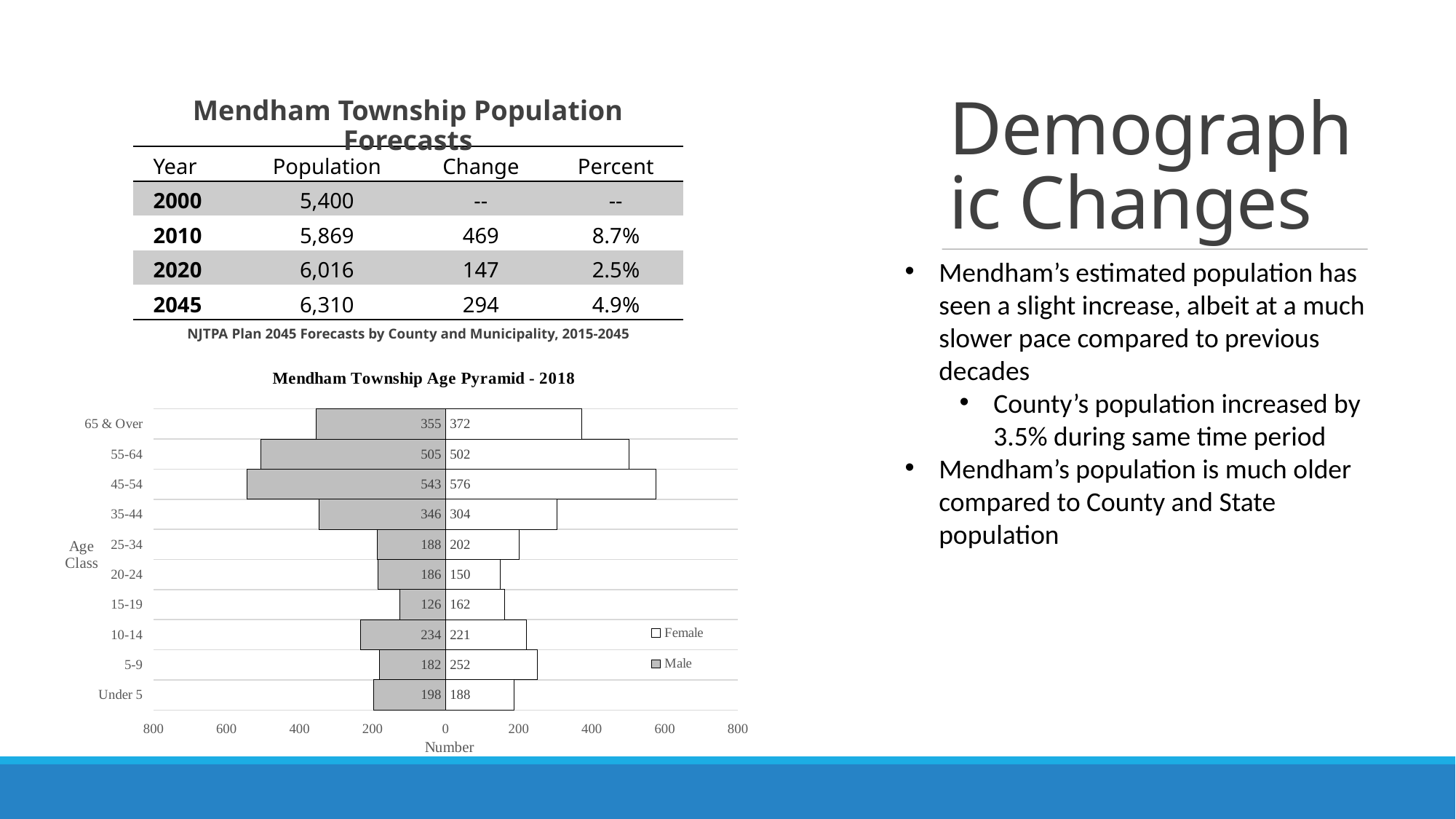
In the Mendham Township Age Pyramid - 2018 chart, which is larger for the 20-24 age class, the Male value or the Female value? Male In the Mendham Township Age Pyramid - 2018 chart, which age class has the lowest Male value? 15-19 In the Mendham Township Age Pyramid - 2018 chart, how many age classes are shown? 10 In the Mendham Township Age Pyramid - 2018 chart, what is the Female value for the 5-9 age class? 252 In the Mendham Township Age Pyramid - 2018 chart, which age class has the highest Male value? 45-54 In the Mendham Township Age Pyramid - 2018 chart, what is the combined Male and Female value for the 45-54 age class? 1119 In the Mendham Township Age Pyramid - 2018 chart, which age class has the lowest Female value? 20-24 What kind of chart is the Mendham Township Age Pyramid - 2018? Bar chart In the Mendham Township Age Pyramid - 2018 chart, how many series does the legend list? 2 In the Mendham Township Age Pyramid - 2018 chart, what is the difference between the Female and Male values for the 5-9 age class? 70 In the Mendham Township Age Pyramid - 2018 chart, what is the Female value for 65 & Over? 372 In the Mendham Township Age Pyramid - 2018 chart, what is the Male value for the 45-54 age class? 543